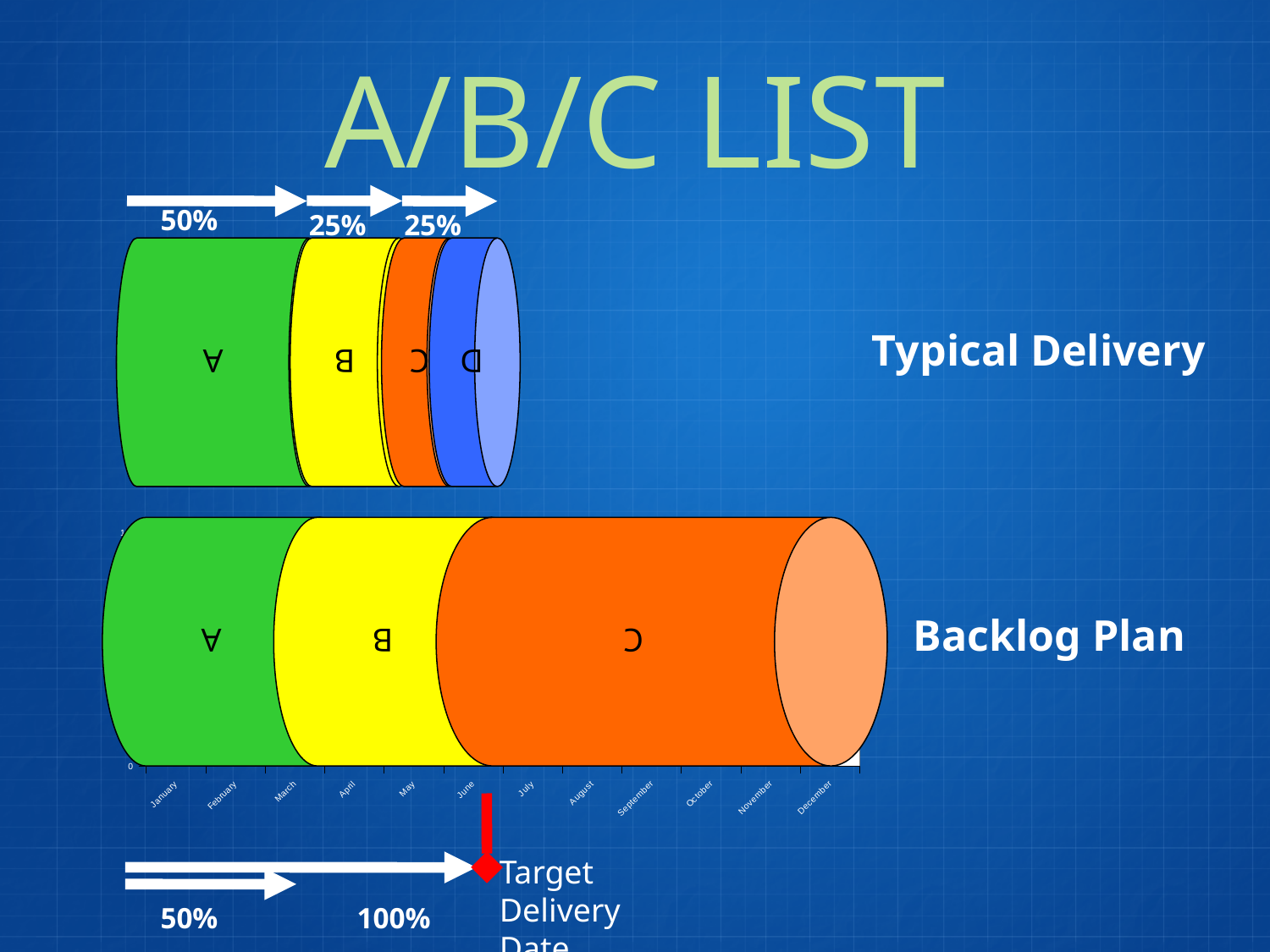
In the Typical Delivery chart, how many segments (A, B, C, D) are shown? 4 In the Typical Delivery chart, which is larger, segment A or segment B? A In the Backlog Plan chart, which segment is the largest? C What is the first month label on the x axis of the Backlog Plan chart? January In the Backlog Plan chart, how many month labels are on the x axis? 12 What colour is segment C in the Backlog Plan chart? orange In the Typical Delivery chart, which segment is the largest? A In the Backlog Plan chart, which is larger, segment B or segment C? C In the Backlog Plan chart, how many segments are shown? 3 In the Backlog Plan chart, which is larger, segment A or segment C? C